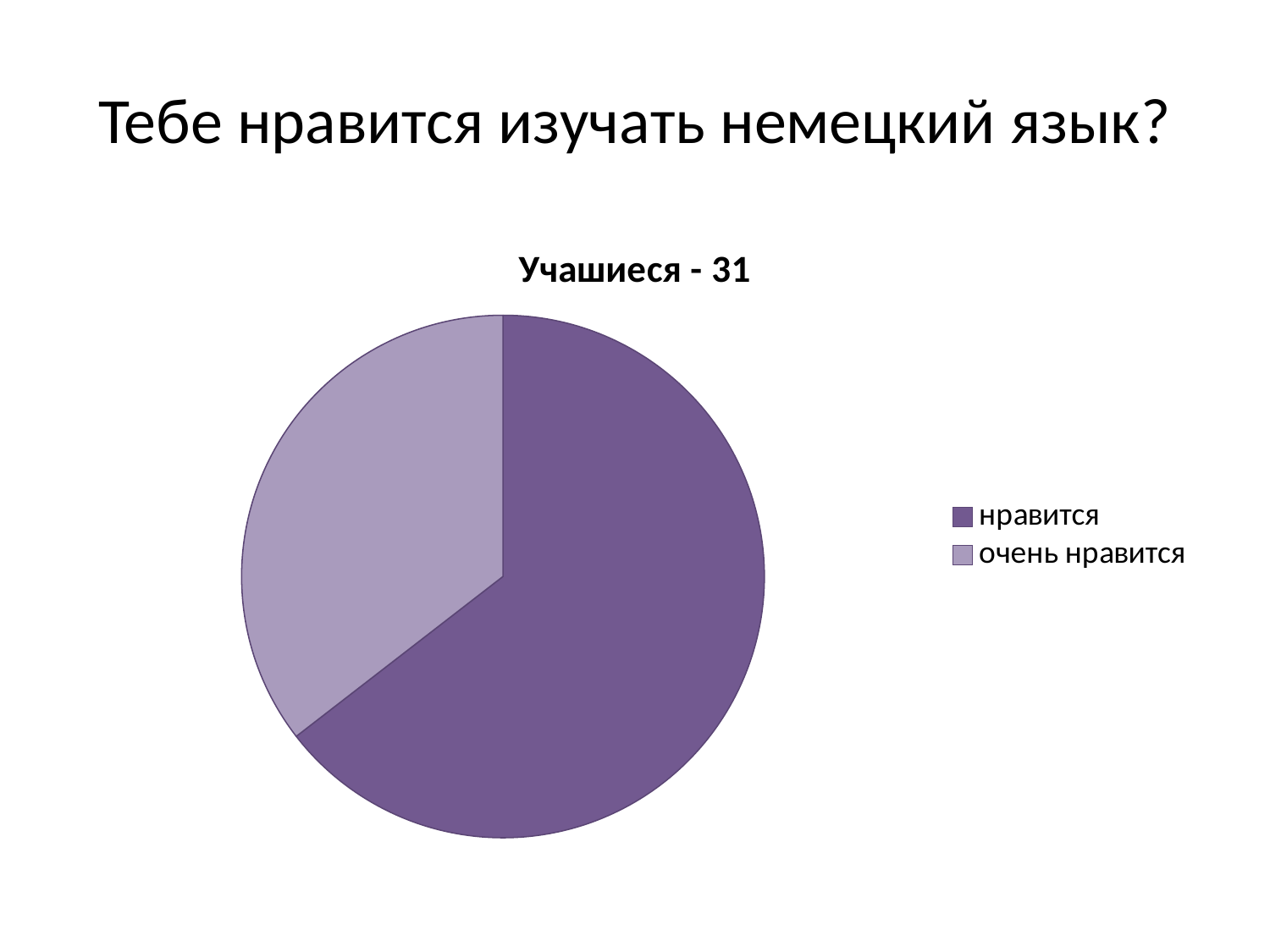
How many entries does the legend of the pie chart list? 2 Which legend entry is shown in the lighter purple colour? очень нравится Which slice is larger, "нравится" or "очень нравится"? нравится What is the title of the pie chart? Учашиеся - 31 What kind of chart is shown on the slide? pie chart How many slices does the pie chart have? 2 Which category has the smallest slice in the pie chart? очень нравится Which category has the largest slice in the pie chart? нравится